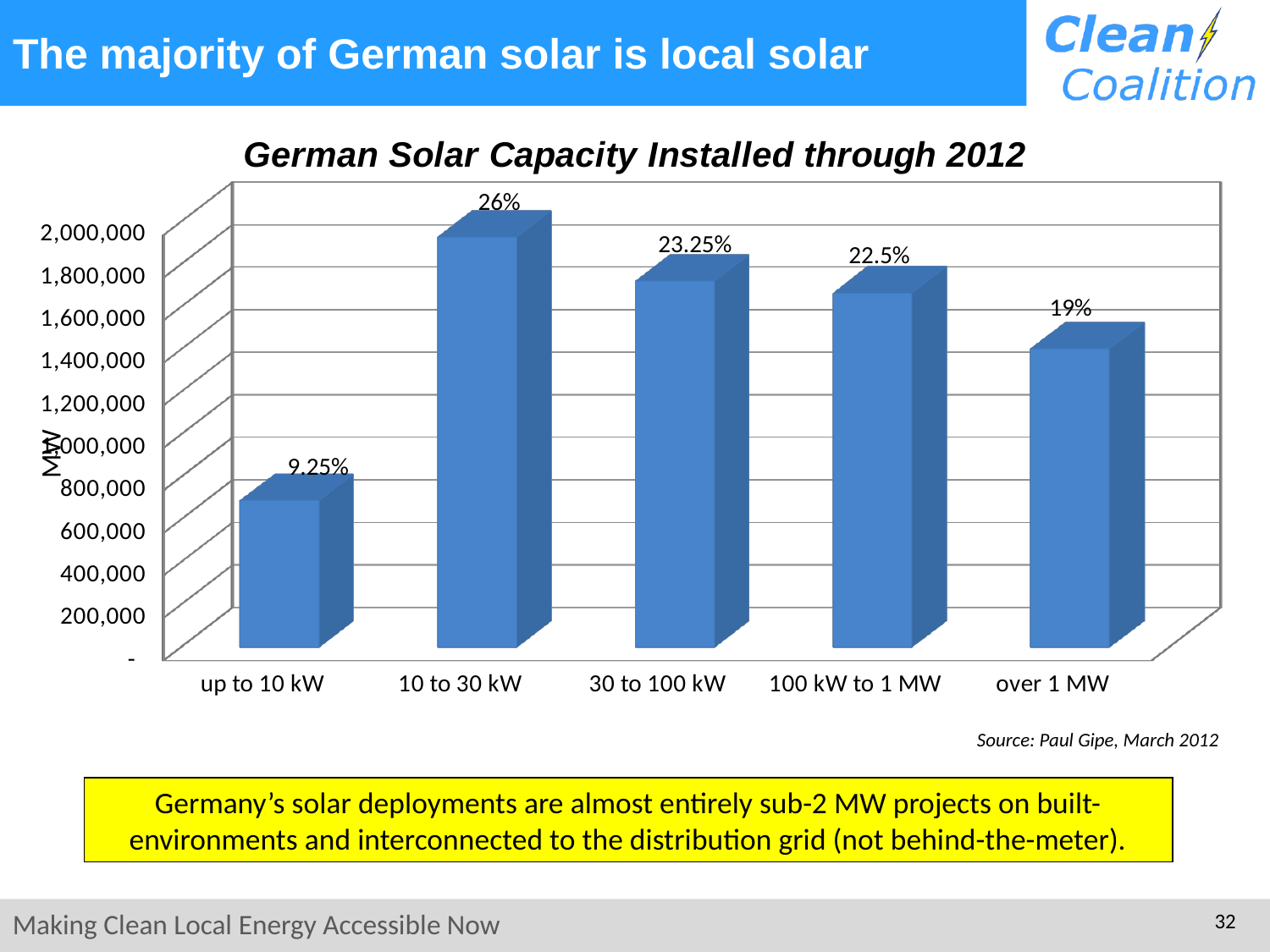
How many capacity categories are shown on the x axis? 5 What percentage label is shown on the '30 to 100 kW' bar? 23.25% What percentage label is shown on the '10 to 30 kW' bar? 26% What percentage label is shown on the 'up to 10 kW' bar? 9.25% What is the difference in percentage points between the '10 to 30 kW' label and the 'up to 10 kW' label? 16.75% Which category has the highest installed capacity? 10 to 30 kW What percentage label is shown on the 'over 1 MW' bar? 19% What percentage label is shown on the '100 kW to 1 MW' bar? 22.5% Which category has the lowest installed capacity? up to 10 kW Which has a larger installed capacity, '30 to 100 kW' or 'over 1 MW'? 30 to 100 kW What type of chart is shown on the slide? Bar chart Is the value for 'up to 10 kW' greater or less than 800,000 MW? less